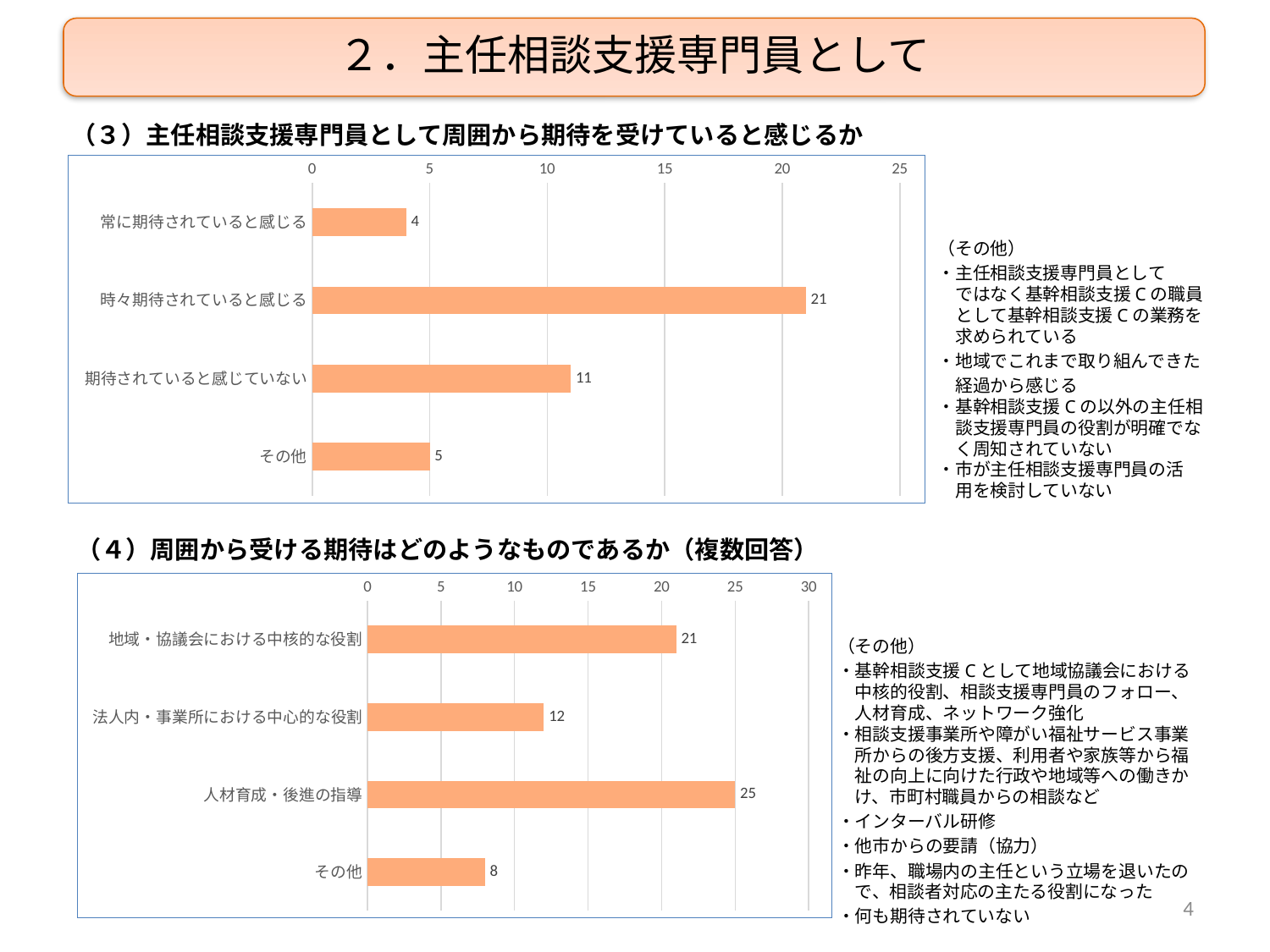
In the bottom chart (4), which category has the highest value? 人材育成・後進の指導 In the bottom chart (4), what is the value for 人材育成・後進の指導? 25 In the bottom chart (4), what is the value for 法人内・事業所における中心的な役割? 12 What type of chart is the bottom chart (4)? bar chart In the bottom chart (4), what is the difference between 人材育成・後進の指導 and その他? 17 In the top chart (3), what is the value for その他? 5 In the top chart (3), what is the value for 時々期待されていると感じる? 21 In the bottom chart (4), which is larger, 地域・協議会における中核的な役割 or 法人内・事業所における中心的な役割? 地域・協議会における中核的な役割 In the top chart (3), how many categories are shown? 4 In the top chart (3), which category has the lowest value? 常に期待されていると感じる In the top chart (3), what is the difference between 時々期待されていると感じる and 期待されていると感じていない? 10 In the bottom chart (4), what is the maximum value shown on the horizontal axis? 30